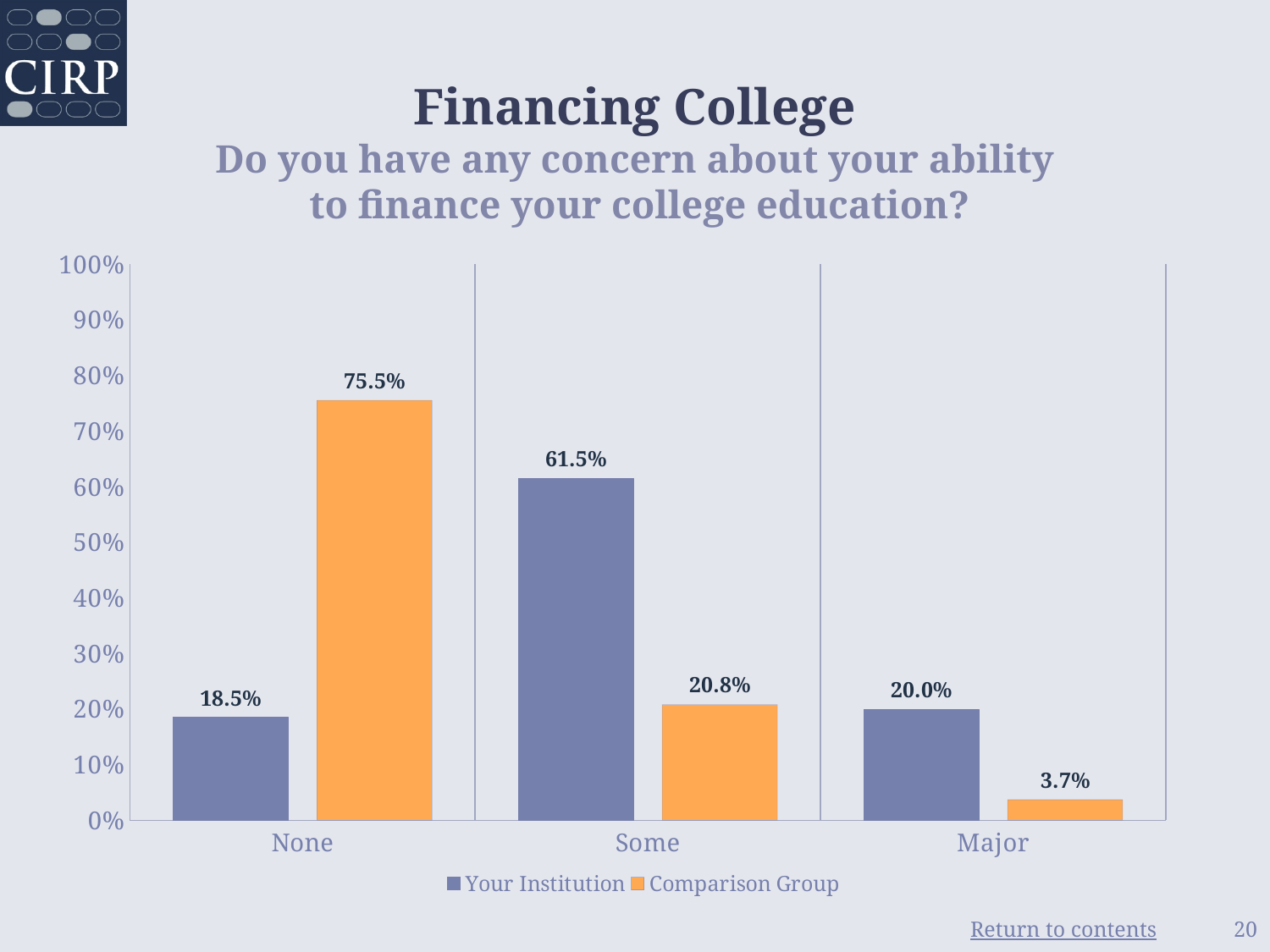
In the Major category, which series has the larger value, Your Institution or Comparison Group? Your Institution Is the value for Your Institution in the Some category greater or less than 50%? greater What is the value for Comparison Group in the Some category? 20.8% How many categories are shown on the x axis? 3 Which category has the lowest value for Comparison Group? Major What is the value for Your Institution in the None category? 18.5% What kind of chart is shown on the slide? bar chart How many series does the legend list? 2 What colour are the Comparison Group bars? orange Which category has the highest value for Your Institution? Some What is the value for Comparison Group in the Major category? 3.7% What is the difference between the Comparison Group and Your Institution values in the None category? 57.0%